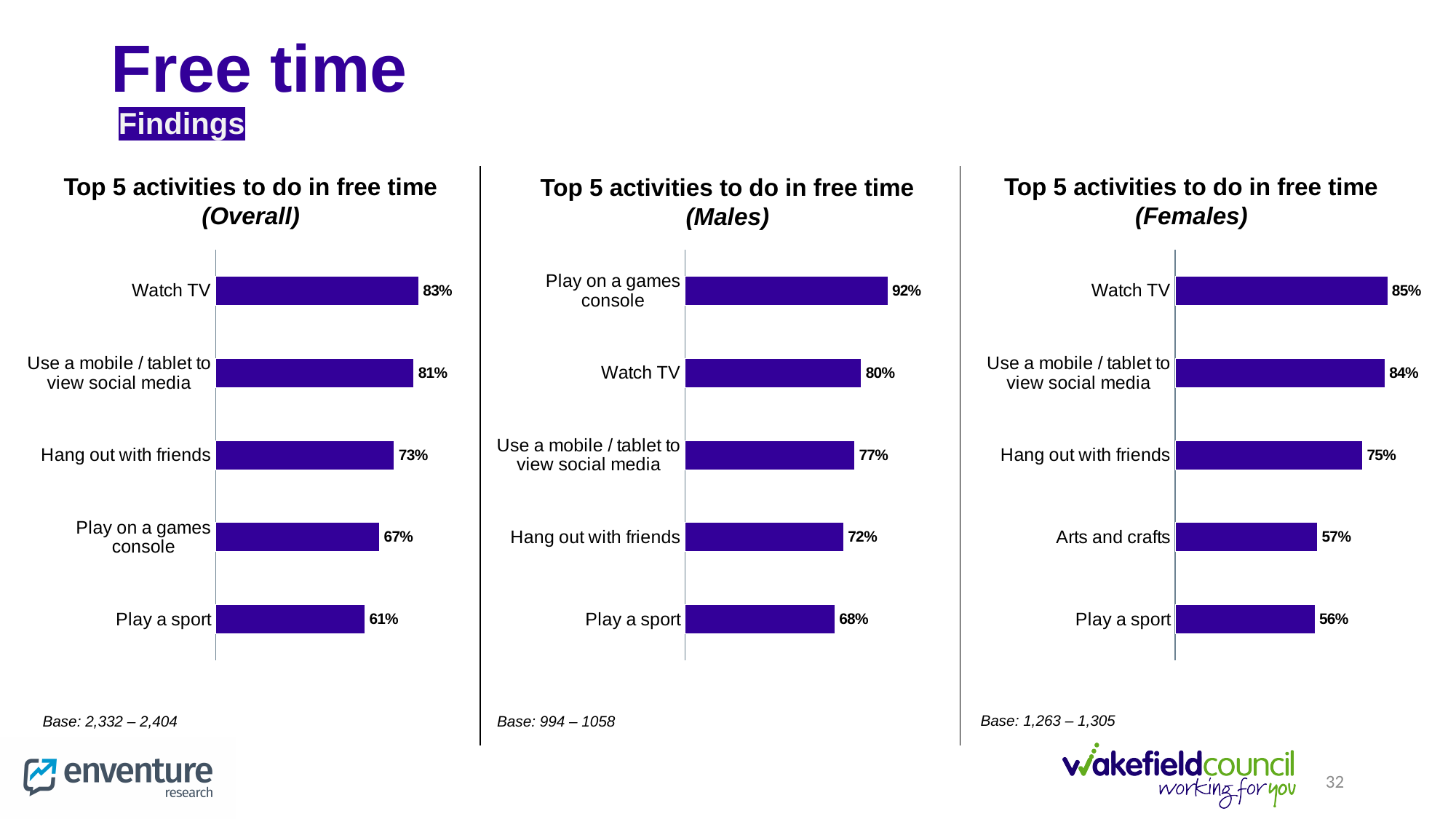
In the 'Top 5 activities to do in free time (Overall)' chart, how many activities are shown? 5 In the 'Top 5 activities to do in free time (Males)' chart, which activity has the lowest value? Play a sport In the 'Top 5 activities to do in free time (Males)' chart, what is the value for Play on a games console? 92% In the 'Top 5 activities to do in free time (Males)' chart, what is the difference between Play on a games console and Watch TV? 12% In the 'Top 5 activities to do in free time (Overall)' chart, what is the difference between Watch TV and Play a sport? 22% Which is larger: Hang out with friends in the Males chart or Hang out with friends in the Females chart? Females chart In the 'Top 5 activities to do in free time (Overall)' chart, what is the value for Play on a games console? 67% What is the base shown under the 'Top 5 activities to do in free time (Males)' chart? 994 – 1058 In the 'Top 5 activities to do in free time (Overall)' chart, what is the value for Watch TV? 83% In the 'Top 5 activities to do in free time (Females)' chart, which activity has the highest value? Watch TV What type of chart is the 'Top 5 activities to do in free time (Females)' chart? Bar chart In the 'Top 5 activities to do in free time (Females)' chart, what is the value for Arts and crafts? 57%